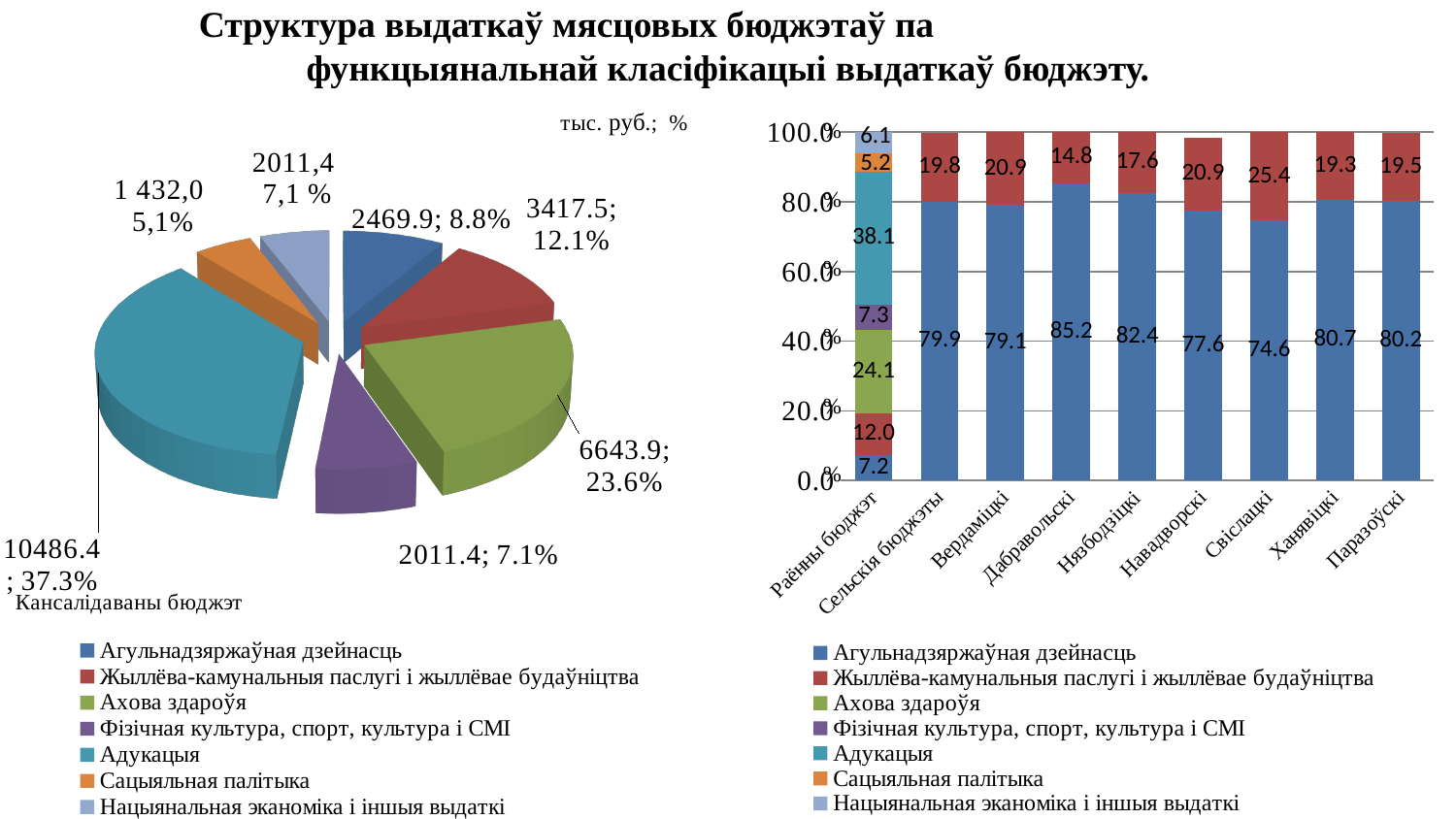
In the pie chart on the left, which category has the largest slice? Адукацыя How many categories are shown on the x axis of the stacked bar chart on the right? 9 In the pie chart on the left, which category has the smallest slice? Сацыяльная палітыка In the stacked bar chart on the right, which budget has the lowest value for Агульнадзяржаўная дзейнасць? Раённы бюджэт In the stacked bar chart on the right, what is the difference between the Агульнадзяржаўная дзейнасць values for Дабравольскі and Свіслацкі? 10.6 How many series does the legend of the stacked bar chart on the right list? 7 What type of chart is shown on the left side of the slide? Pie chart In the stacked bar chart on the right, what is the value of Адукацыя for Раённы бюджэт? 38.1 In the pie chart on the left, what share of the pie does Ахова здароўя take? 23.6% In the stacked bar chart on the right, what is the value of Жыллёва-камунальныя паслугі і жыллёвае будаўніцтва for Свіслацкі? 25.4 In the stacked bar chart on the right, what is the value of Агульнадзяржаўная дзейнасць for Дабравольскі? 85.2 In the pie chart on the left, what value and share are shown for Адукацыя? 10486.4; 37.3%